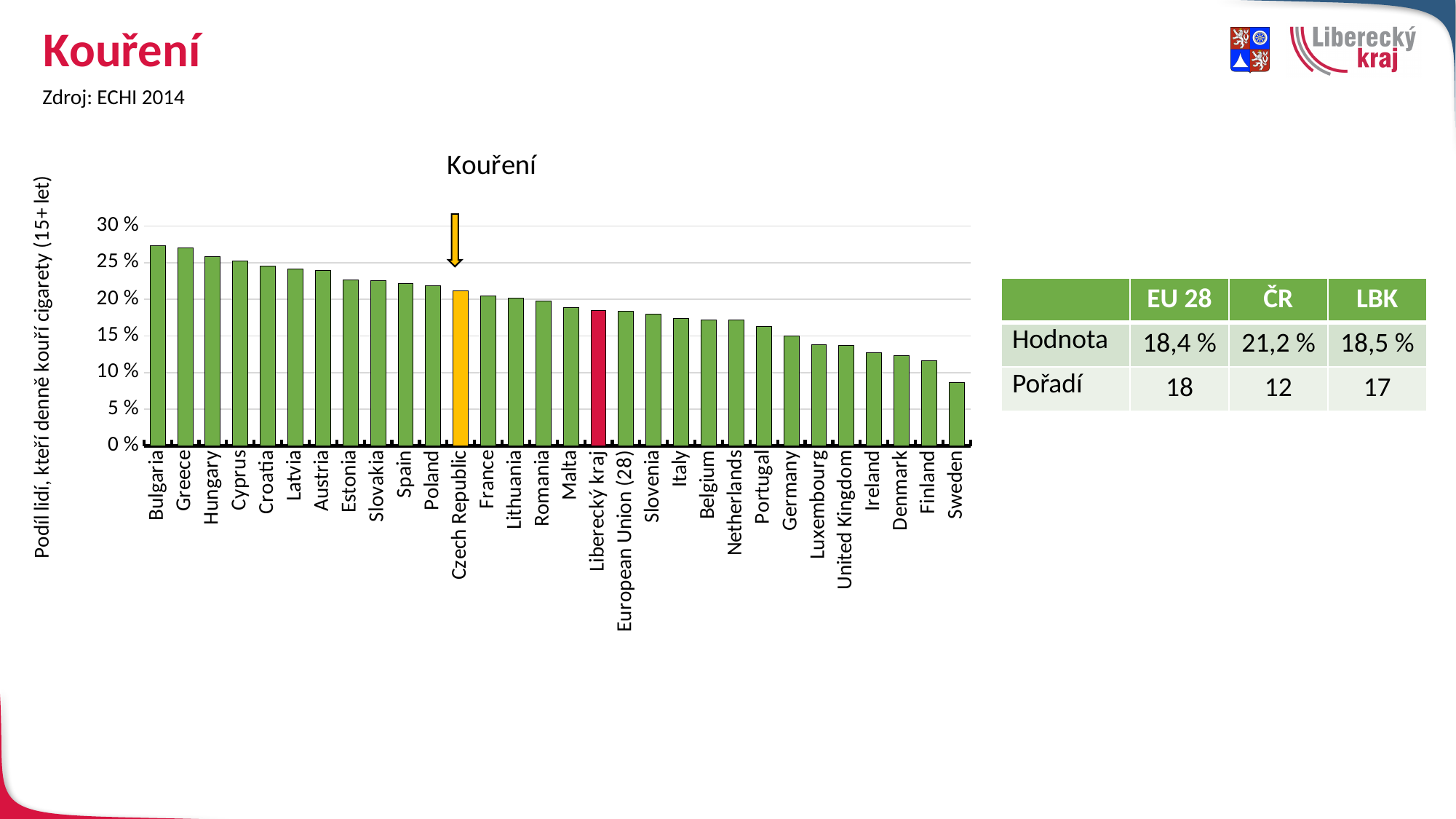
Is the value for Slovenia greater or less than 20 %? less What is the value for European Union (28)? 18,4 % Which category has the lowest value in the chart? Sweden What is the value for Czech Republic (ČR) in the chart? 21,2 % What is the difference between the value for Czech Republic (21,2 %) and Liberecký kraj (18,5 %)? 2,7 % Is the value for Bulgaria greater or less than 25 %? greater Which is larger, the value for Czech Republic or the value for Liberecký kraj? Czech Republic What is the value for Liberecký kraj (LBK)? 18,5 % How many categories (bars) are shown in the chart? 30 Do the values rise or fall from left to right along the x axis? fall Is the value for Sweden greater or less than 10 %? less What kind of chart is shown on the slide? bar chart